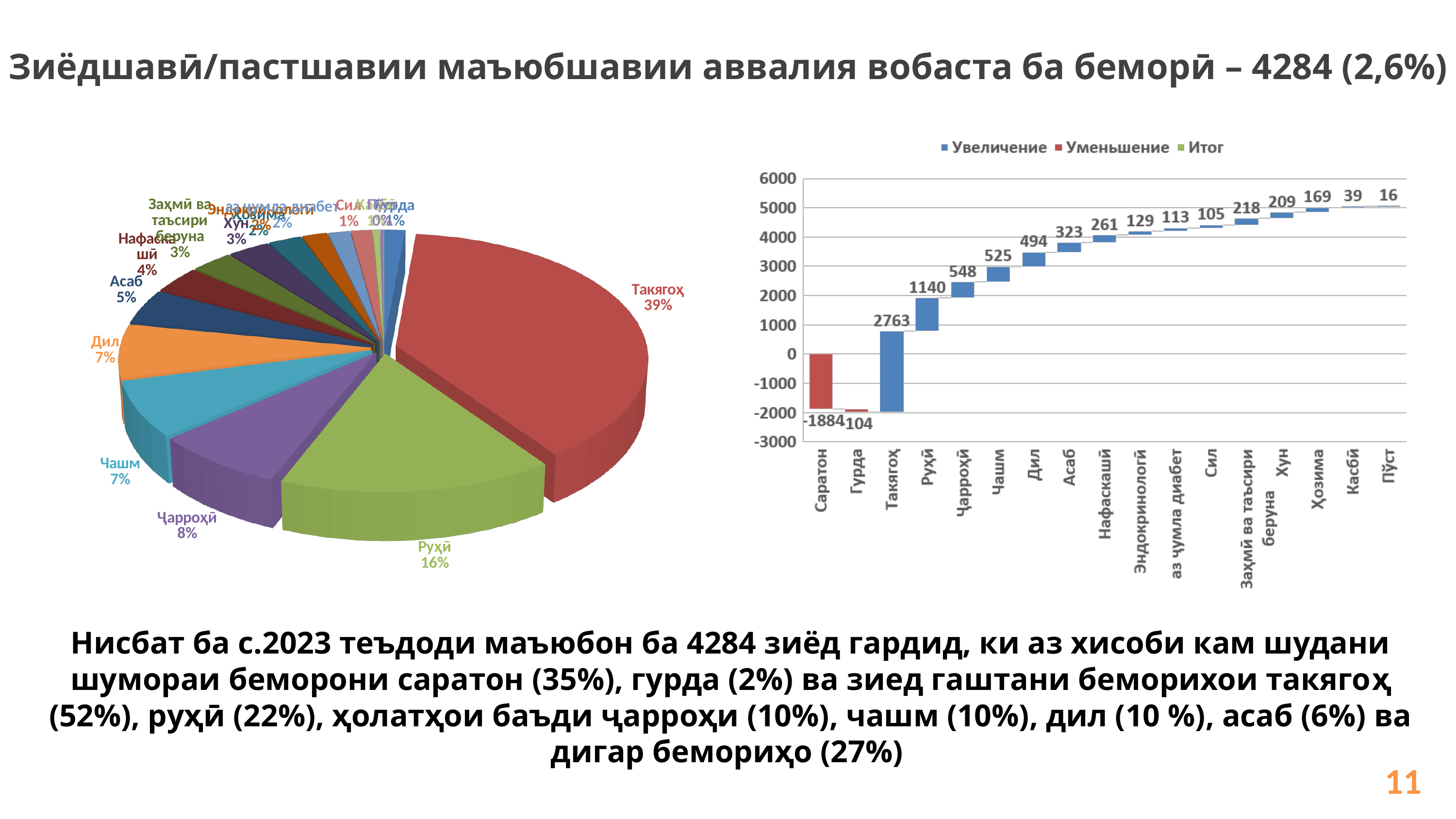
In the bar chart on the right, which is larger, the value for Руҳӣ or the value for Ҷарроҳӣ? Руҳӣ In the bar chart on the right, what is the value for Саратон? -1884 In the pie chart on the left, what share does Такягоҳ have? 39% In the bar chart on the right, which category has the lowest value? Саратон What kind of chart is on the left of the slide? Pie chart In the bar chart on the right, what is the difference between the values for Чашм and Дил? 31 How many entries does the legend of the bar chart on the right list? 3 In the pie chart on the left, what share does Руҳӣ have? 16% In the bar chart on the right, what is the value for Пӯст? 16 In the pie chart on the left, which category has the largest slice? Такягоҳ In the bar chart on the right, what is the value for Такягоҳ? 2763 In the pie chart on the left, what is the difference in percentage points between Ҷарроҳӣ and Асаб? 3